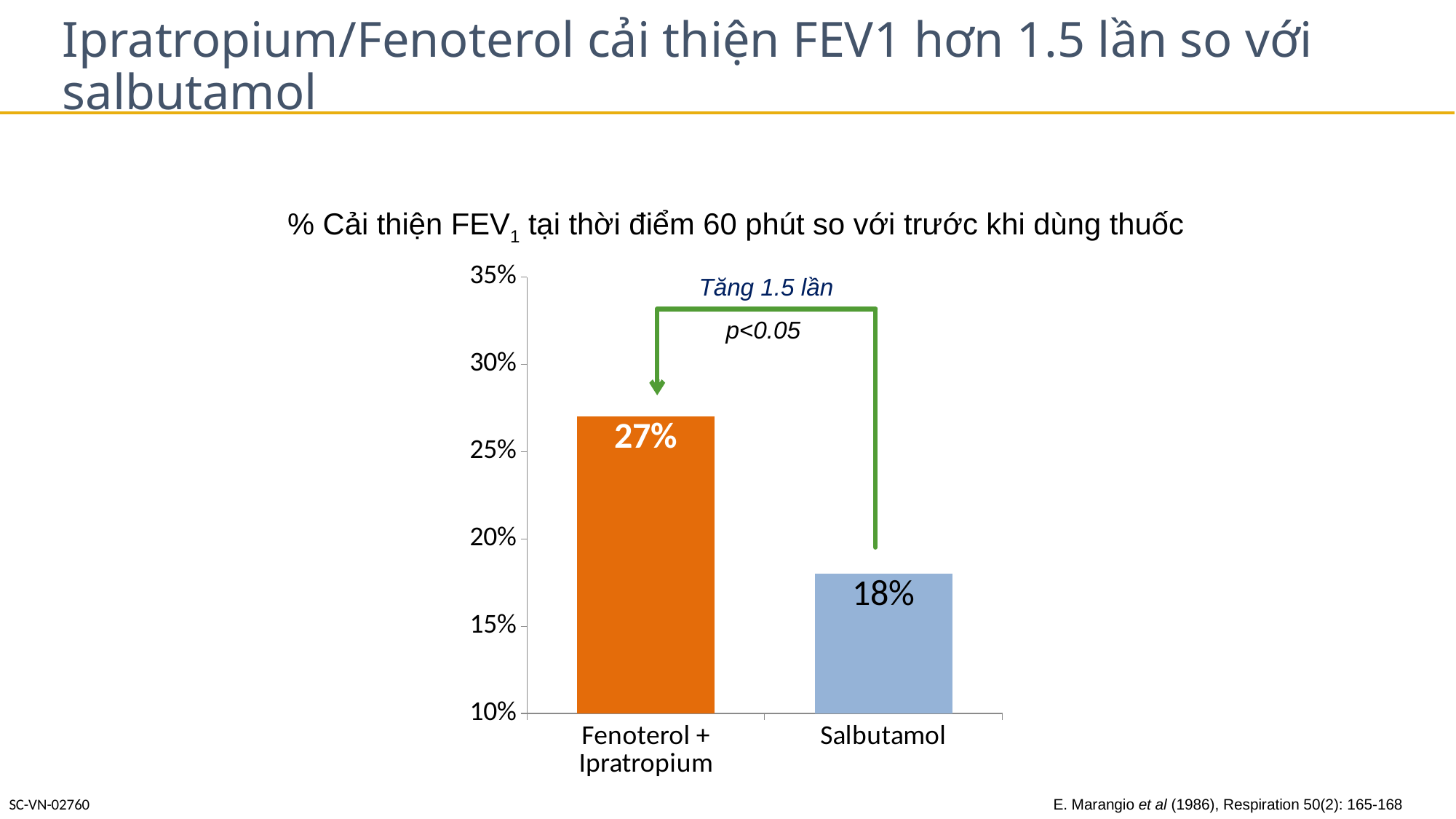
Is the value for Fenoterol + Ipratropium greater or less than 25%? greater What is the value for Fenoterol + Ipratropium? 27% Which category has the lowest value? Salbutamol What p-value is annotated on the chart? p<0.05 What is the difference between the values for Fenoterol + Ipratropium and Salbutamol? 9% Is the value for Salbutamol greater or less than 20%? less Which category has the highest value? Fenoterol + Ipratropium Which is larger, the value for Fenoterol + Ipratropium or the value for Salbutamol? Fenoterol + Ipratropium What is the highest value shown on the vertical axis? 35% What kind of chart is shown on the slide? Bar chart What is the value for Salbutamol? 18% How many categories are shown in the chart? 2